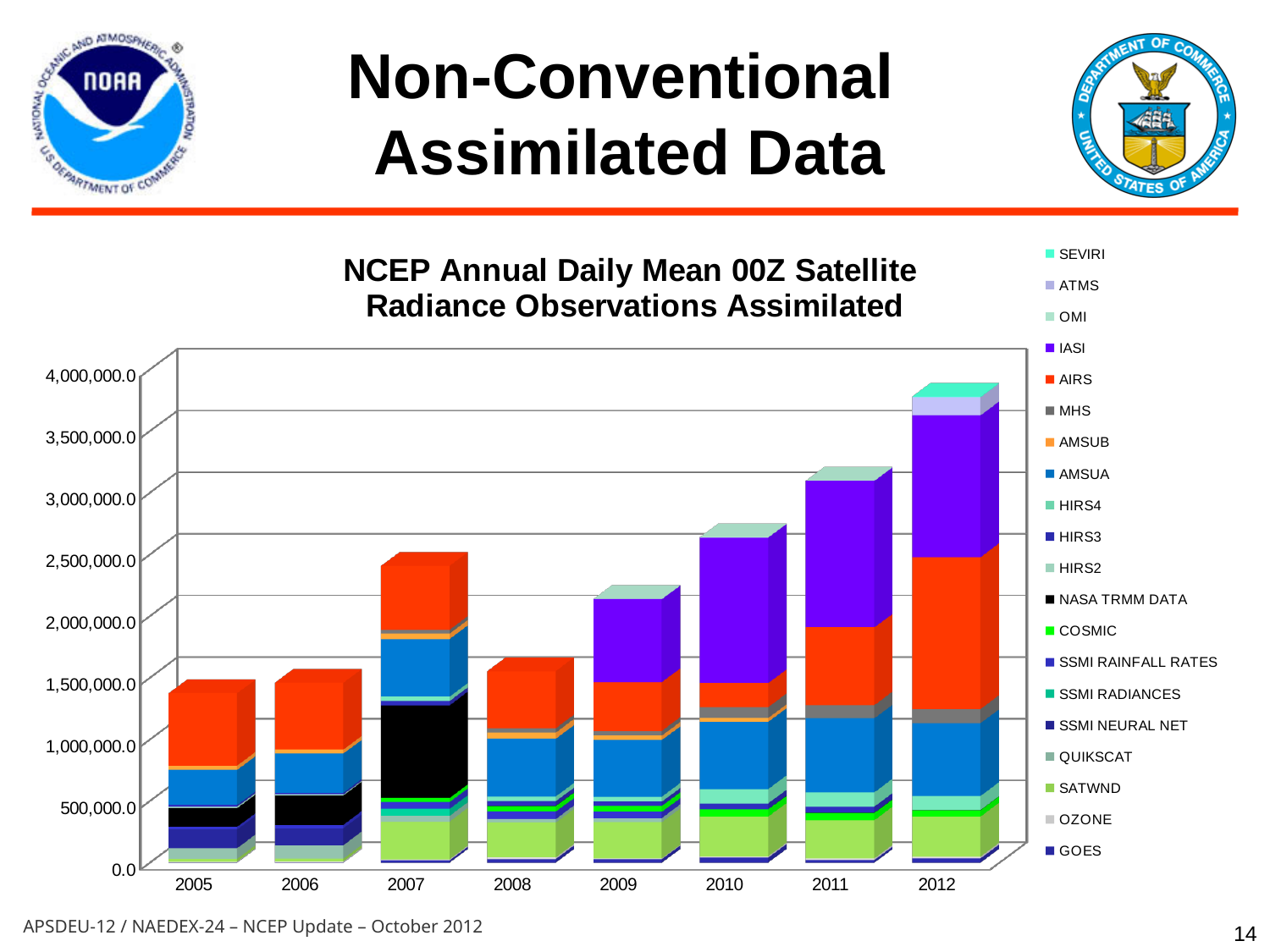
Which year has the larger total, 2011 or 2012? 2012 Is the total for 2012 greater or less than 3,500,000? greater Is the total for 2008 greater or less than 2,000,000? less What kind of chart is shown on the slide? Stacked bar chart What is the title of the chart? NCEP Annual Daily Mean 00Z Satellite Radiance Observations Assimilated How many series does the chart's legend list? 20 Do the bar totals generally rise or fall from 2005 to 2012? rise Is the total for 2007 greater or less than 2,000,000? greater Which year has the highest total of satellite radiance observations assimilated? 2012 Which year has the larger total, 2007 or 2008? 2007 How many years are shown along the x axis of the chart? 8